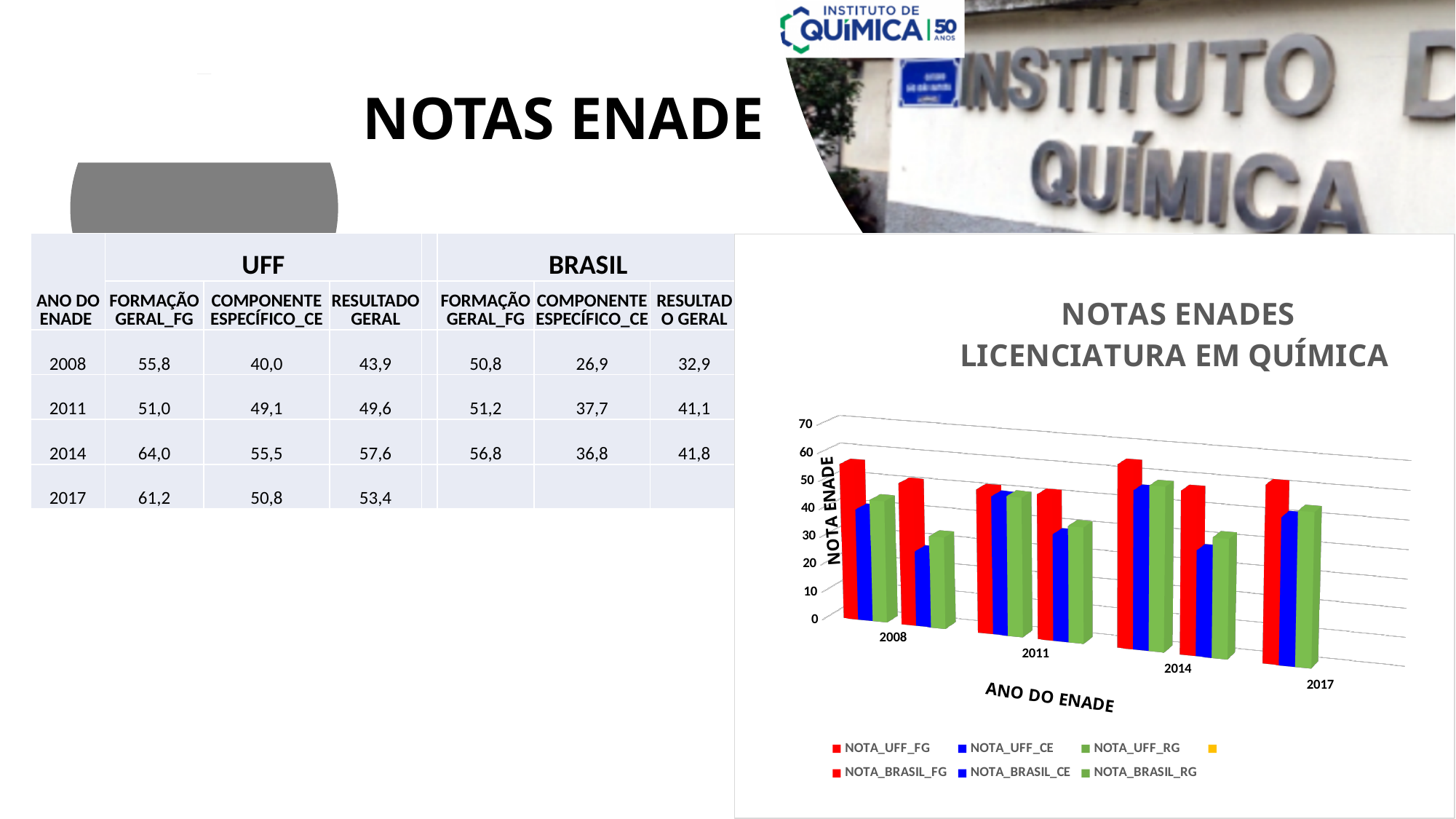
What is the difference between NOTA_UFF_FG and NOTA_BRASIL_FG for 2008? 5,0 What is the title of the chart? NOTAS ENADES LICENCIATURA EM QUÍMICA What is the value of NOTA_UFF_RG for 2017? 53,4 In which year is NOTA_UFF_FG highest? 2014 What is the label of the chart's x axis? ANO DO ENADE In which year is NOTA_UFF_CE lowest? 2008 What is the value of NOTA_UFF_FG for 2008? 55,8 Is the value of NOTA_BRASIL_CE for 2008 greater or less than 30? less What is the value of NOTA_BRASIL_CE for 2008? 26,9 Which is larger for 2008, NOTA_UFF_FG or NOTA_BRASIL_FG? NOTA_UFF_FG What kind of chart is shown on the slide? bar chart How many ENADE years are shown on the x axis of the chart? 4